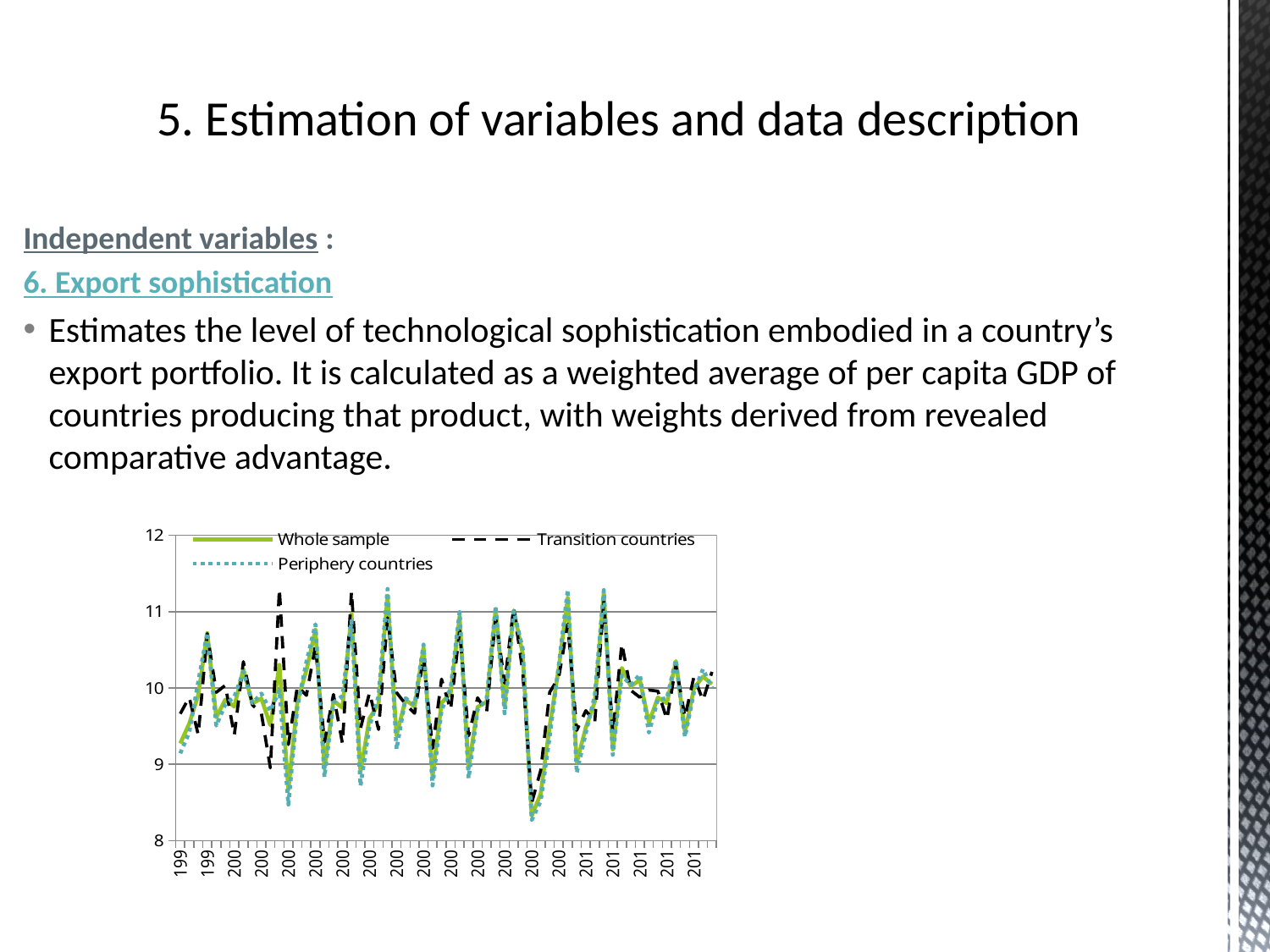
Is the lowest value reached by the Transition countries series greater or less than 9? less Is the highest value reached by the Whole sample series greater or less than 11? greater Which series in the chart is drawn as a black dashed line? Transition countries What kind of chart is shown on the slide? line chart How many series does the chart's legend list? 3 What are the three series named in the chart's legend? Whole sample, Transition countries, Periphery countries Is the lowest value reached by the Periphery countries series greater or less than 9? less